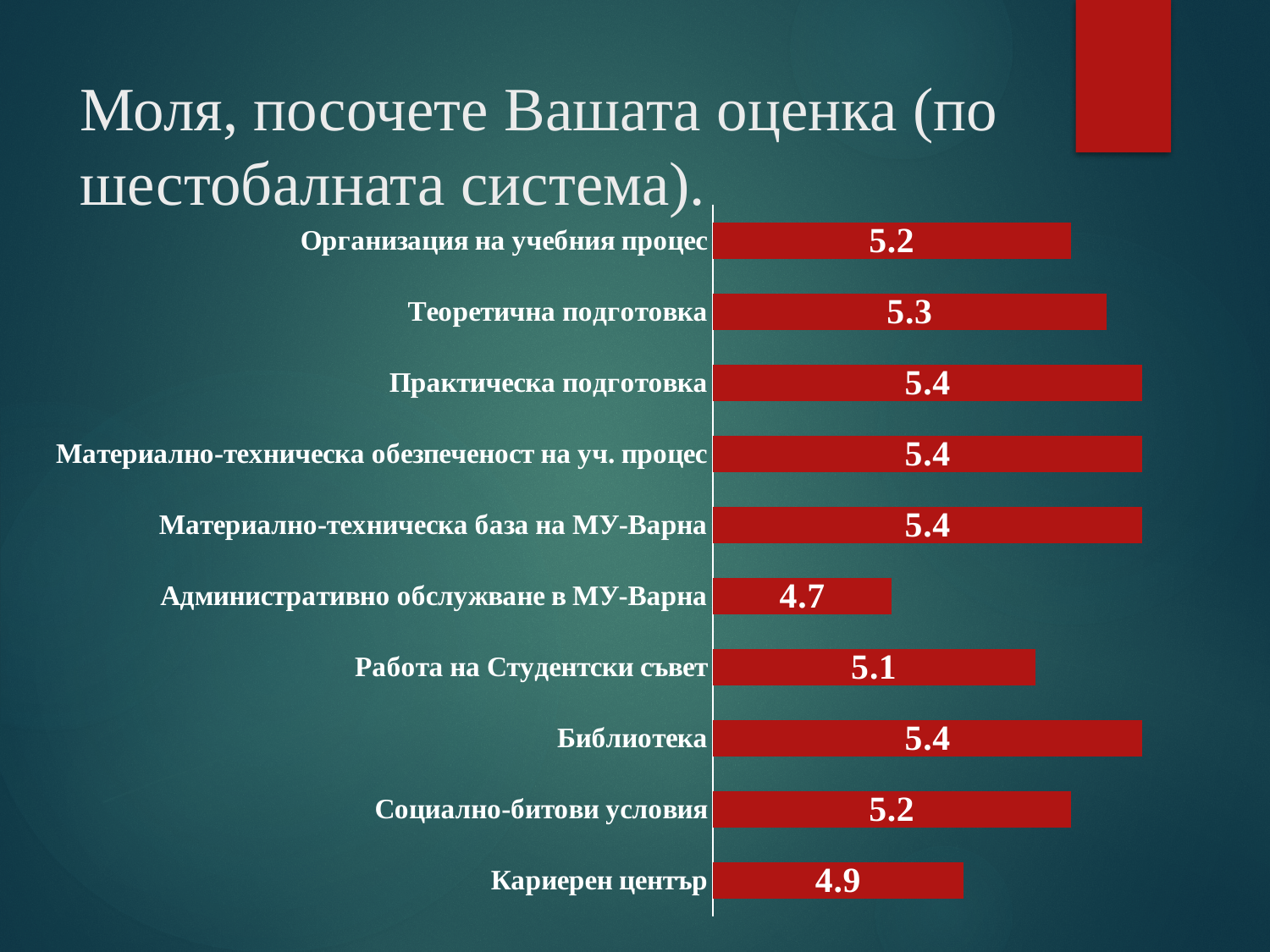
How many categories are shown in the chart? 10 What colour are the bars in the chart? Red What is the value for Работа на Студентски съвет? 5.1 What is the difference between the values for Организация на учебния процес and Административно обслужване в МУ-Варна? 0.5 What is the value for Теоретична подготовка? 5.3 What is the difference between the values for Практическа подготовка and Кариерен център? 0.5 What is the value for Кариерен център? 4.9 What is the value for Административно обслужване в МУ-Варна? 4.7 What kind of chart is shown on the slide? Bar chart Which is larger, the value for Теоретична подготовка or the value for Работа на Студентски съвет? Теоретична подготовка Which category has the lowest value? Административно обслужване в МУ-Варна What is the value for Библиотека? 5.4